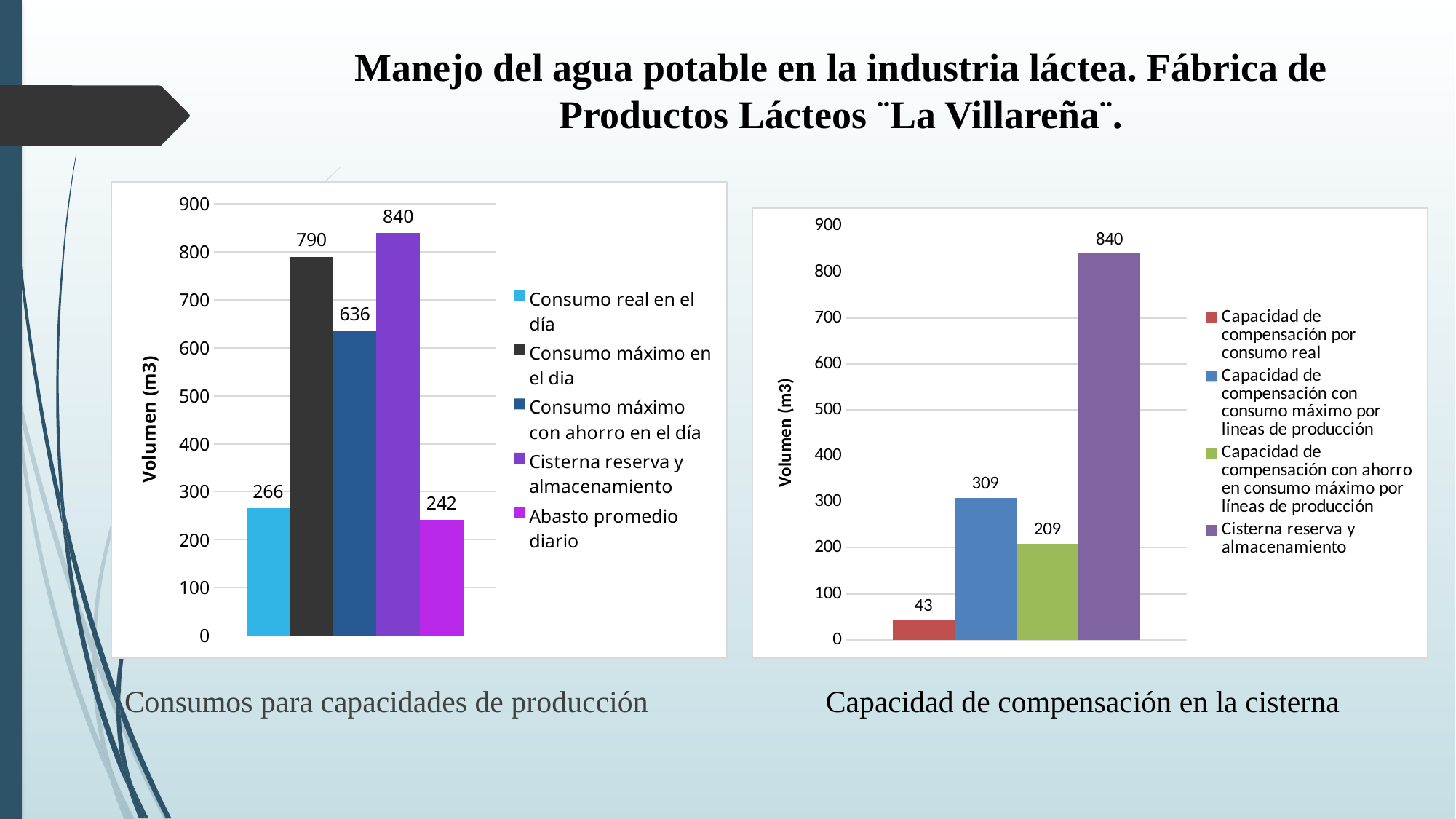
In the right chart (Capacidad de compensación en la cisterna), which series has the lowest value? Capacidad de compensación por consumo real In the left chart (Consumos para capacidades de producción), what is the value for Abasto promedio diario? 242 In the right chart (Capacidad de compensación en la cisterna), what is the value for Capacidad de compensación por consumo real? 43 What kind of chart is the right chart (Capacidad de compensación en la cisterna)? Bar chart In the left chart (Consumos para capacidades de producción), how many series does the legend list? 5 In the left chart (Consumos para capacidades de producción), which series has the highest value? Cisterna reserva y almacenamiento In the left chart (Consumos para capacidades de producción), which series has the lowest value? Abasto promedio diario In the left chart (Consumos para capacidades de producción), what is the difference between Consumo máximo en el dia and Consumo máximo con ahorro en el día? 154 In the right chart (Capacidad de compensación en la cisterna), which is larger: Capacidad de compensación con consumo máximo por lineas de producción or Capacidad de compensación con ahorro en consumo máximo por líneas de producción? Capacidad de compensación con consumo máximo por lineas de producción In the right chart (Capacidad de compensación en la cisterna), what is the difference between Cisterna reserva y almacenamiento and Capacidad de compensación con consumo máximo por lineas de producción? 531 In the left chart (Consumos para capacidades de producción), what is the value for Consumo máximo en el dia? 790 In the right chart (Capacidad de compensación en la cisterna), what is the value for Capacidad de compensación con ahorro en consumo máximo por líneas de producción? 209